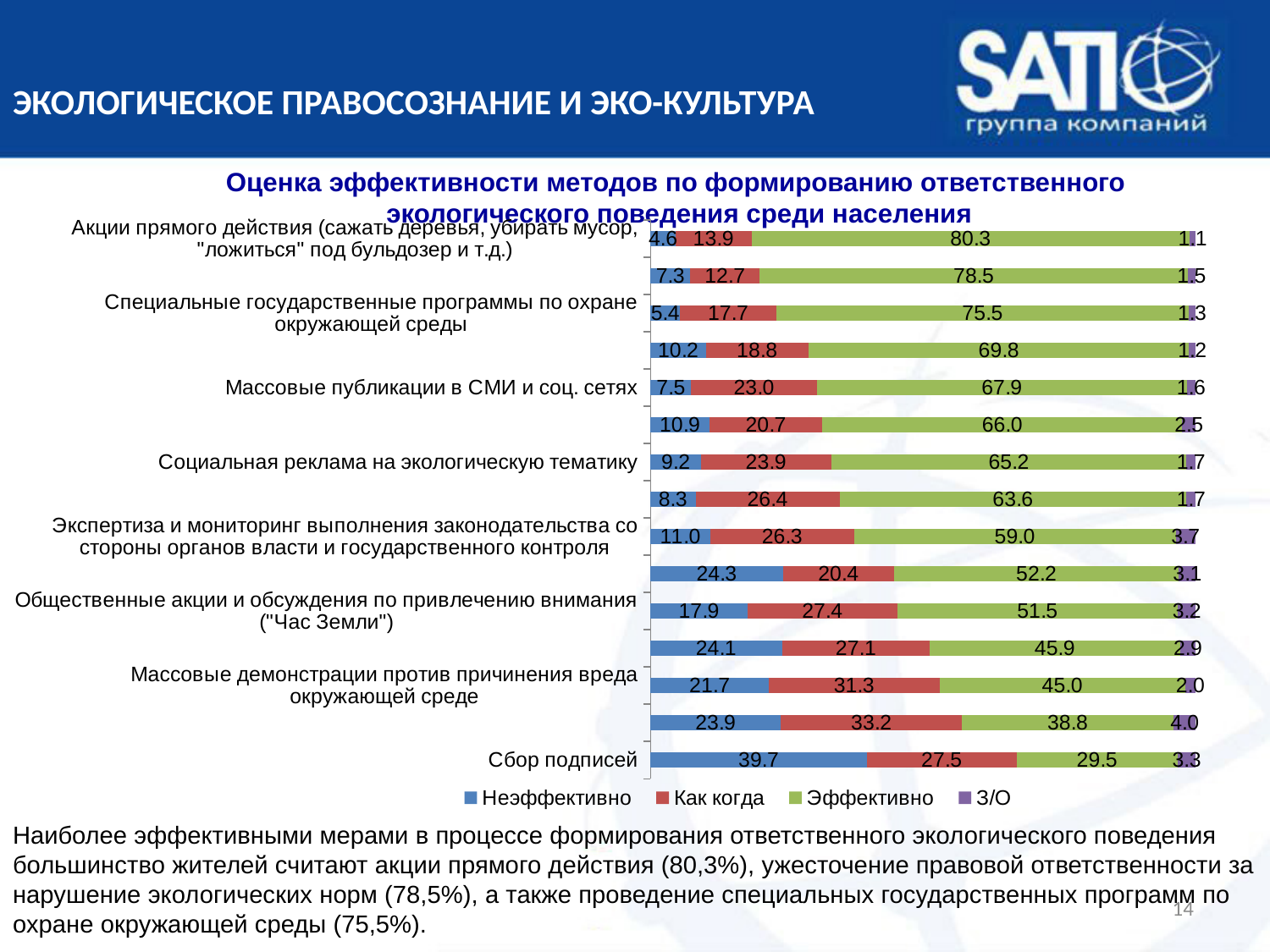
How many series does the legend list? 4 What is the total of the stacked bar for "Сбор подписей"? 100.0 What is the difference between the "Эффективно" values for "Акции прямого действия" and "Специальные государственные программы по охране окружающей среды"? 4.8 What is the "Неэффективно" value for "Сбор подписей"? 39.7 What is the "З/О" value for "Экспертиза и мониторинг выполнения законодательства со стороны органов власти и государственного контроля"? 3.7 Which labelled category has the highest "Эффективно" value? Акции прямого действия Which is larger: the "Эффективно" value for "Массовые публикации в СМИ и соц. сетях" or for "Социальная реклама на экологическую тематику"? Массовые публикации в СМИ и соц. сетях What type of chart is shown on the slide? Stacked bar chart Which labelled category has the highest "Неэффективно" value? Сбор подписей What is the "Эффективно" value for "Акции прямого действия"? 80.3 Which labelled category has the lowest "Эффективно" value? Сбор подписей What is the "Как когда" value for "Массовые демонстрации против причинения вреда окружающей среде"? 31.3